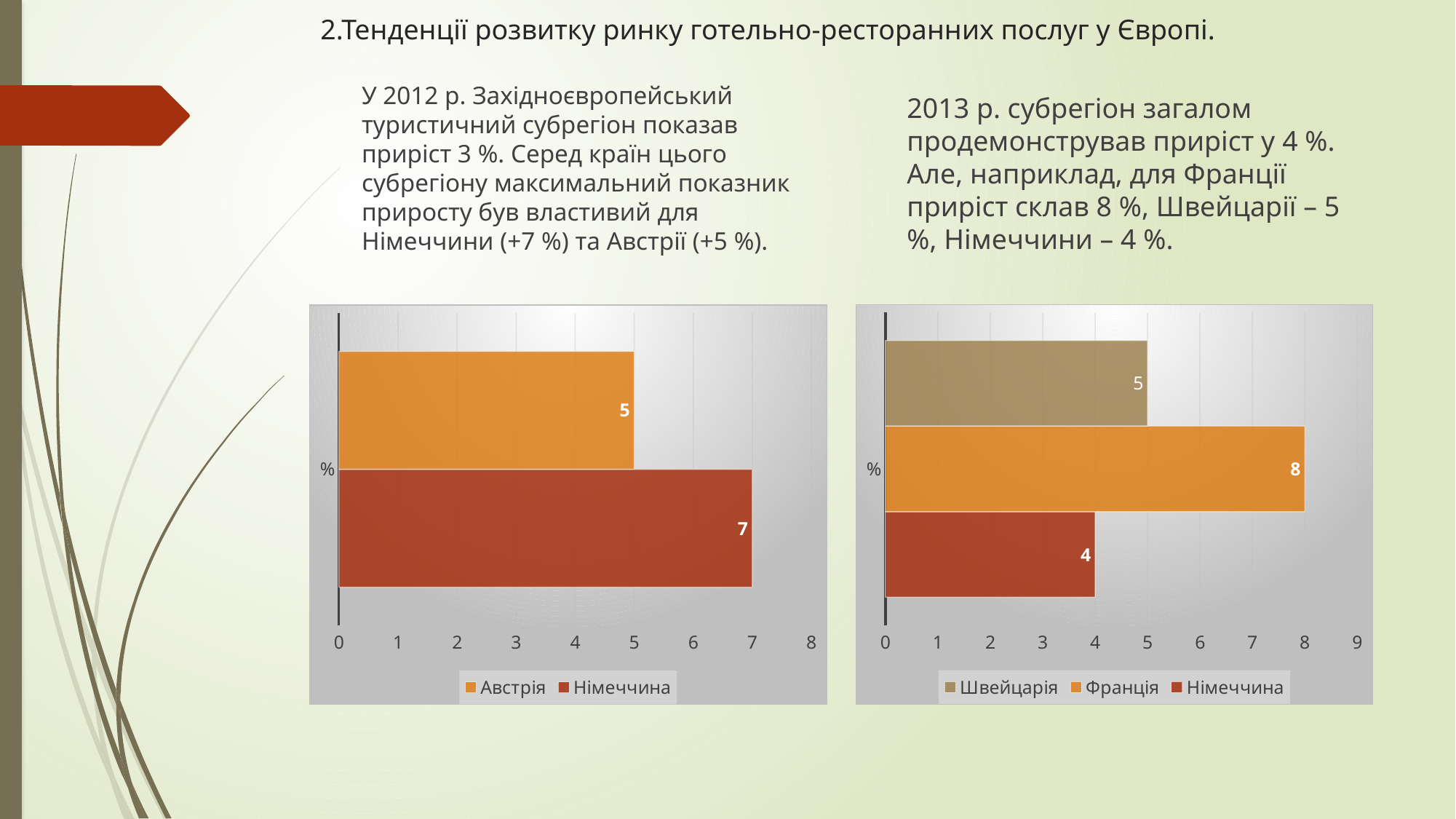
In the right chart, which series has the highest value? Франція In the right chart, what is the value for Швейцарія? 5 In the left chart, what is the value for Німеччина? 7 In the left chart, which is larger: the value for Австрія or the value for Німеччина? Німеччина In the right chart, what is the value for Німеччина? 4 In the right chart, what is the value for Франція? 8 What kind of chart is the left chart? Bar chart In the left chart, what is the value for Австрія? 5 In the left chart, what is the difference between the values for Німеччина and Австрія? 2 In the right chart, which series has the lowest value? Німеччина In the right chart, what is the difference between the values for Франція and Німеччина? 4 How many series does the legend of the right chart list? 3